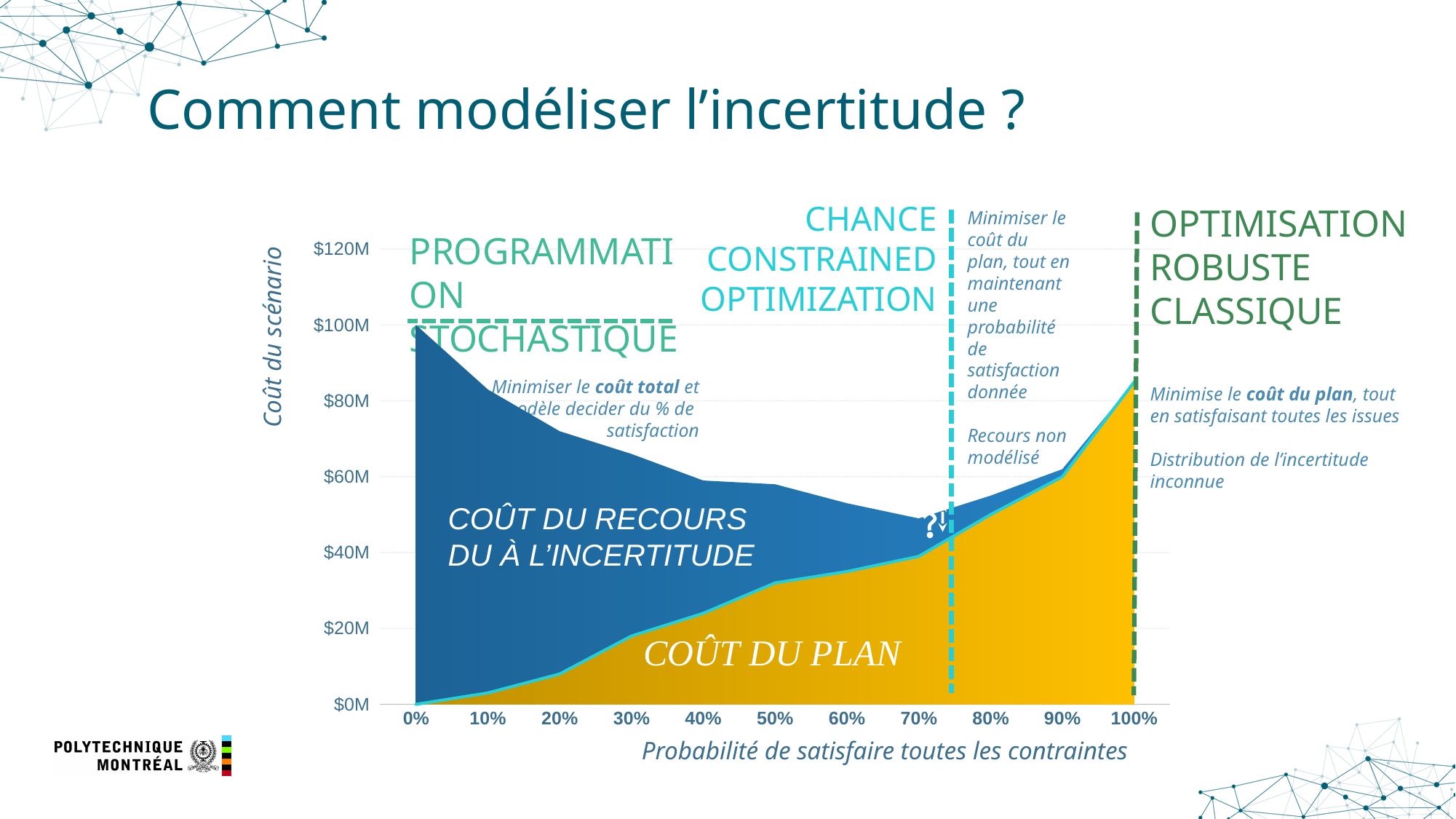
What is the title of the chart's vertical axis? Coût du scénario What is the value of COÛT DU PLAN at 0%? $0M What is the title of the chart's horizontal axis? Probabilité de satisfaire toutes les contraintes Is the value of COÛT DU PLAN at 20% greater or less than $20M? less Is the value of COÛT DU PLAN at 100% greater or less than $80M? greater What kind of chart is shown on the slide? area chart Does COÛT DU RECOURS DU À L'INCERTITUDE rise or fall as the probability increases from 0% to 100%? fall Is the total scenario cost at 0% greater or less than $80M? greater At 30%, which is larger: COÛT DU PLAN or COÛT DU RECOURS DU À L'INCERTITUDE? COÛT DU RECOURS DU À L'INCERTITUDE Does COÛT DU PLAN rise or fall as the probability increases from 0% to 100%? rise How many tick labels are shown on the horizontal axis? 11